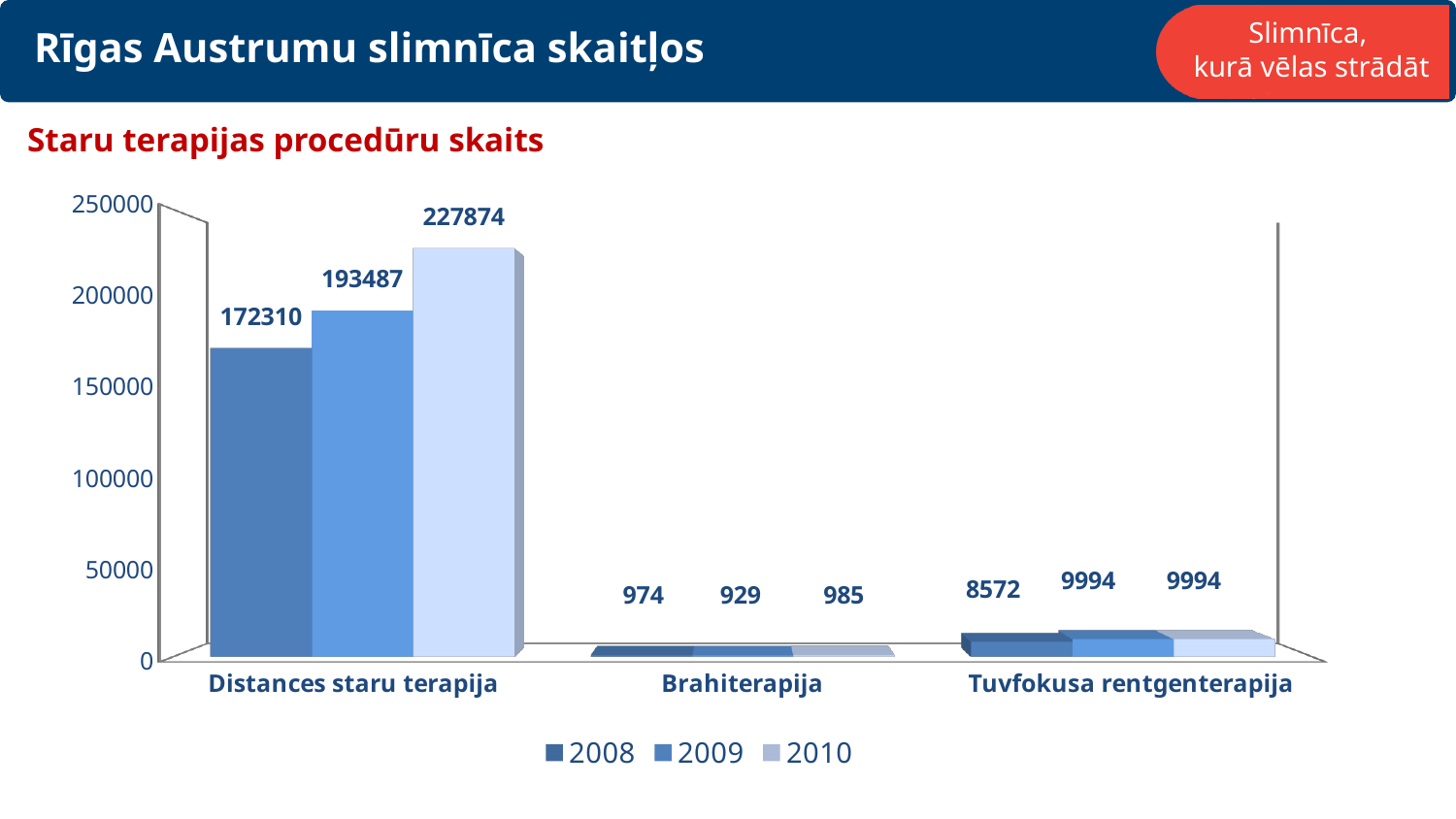
Which category has the highest value in 2008? Distances staru terapija What is the title of the chart? Staru terapijas procedūru skaits How many categories are shown on the x axis? 3 What kind of chart is shown on the slide? bar chart Which category has the lowest value in 2010? Brahiterapija What is the difference between the 2010 and 2008 values for Distances staru terapija? 55564 What is the value for Distances staru terapija in 2010? 227874 Which is larger for Brahiterapija: the 2008 value or the 2010 value? 2010 How many series does the legend list? 3 What is the value for Brahiterapija in 2009? 929 What is the value for Tuvfokusa rentgenterapija in 2008? 8572 Is the value for Distances staru terapija in 2009 greater or less than 200000? less